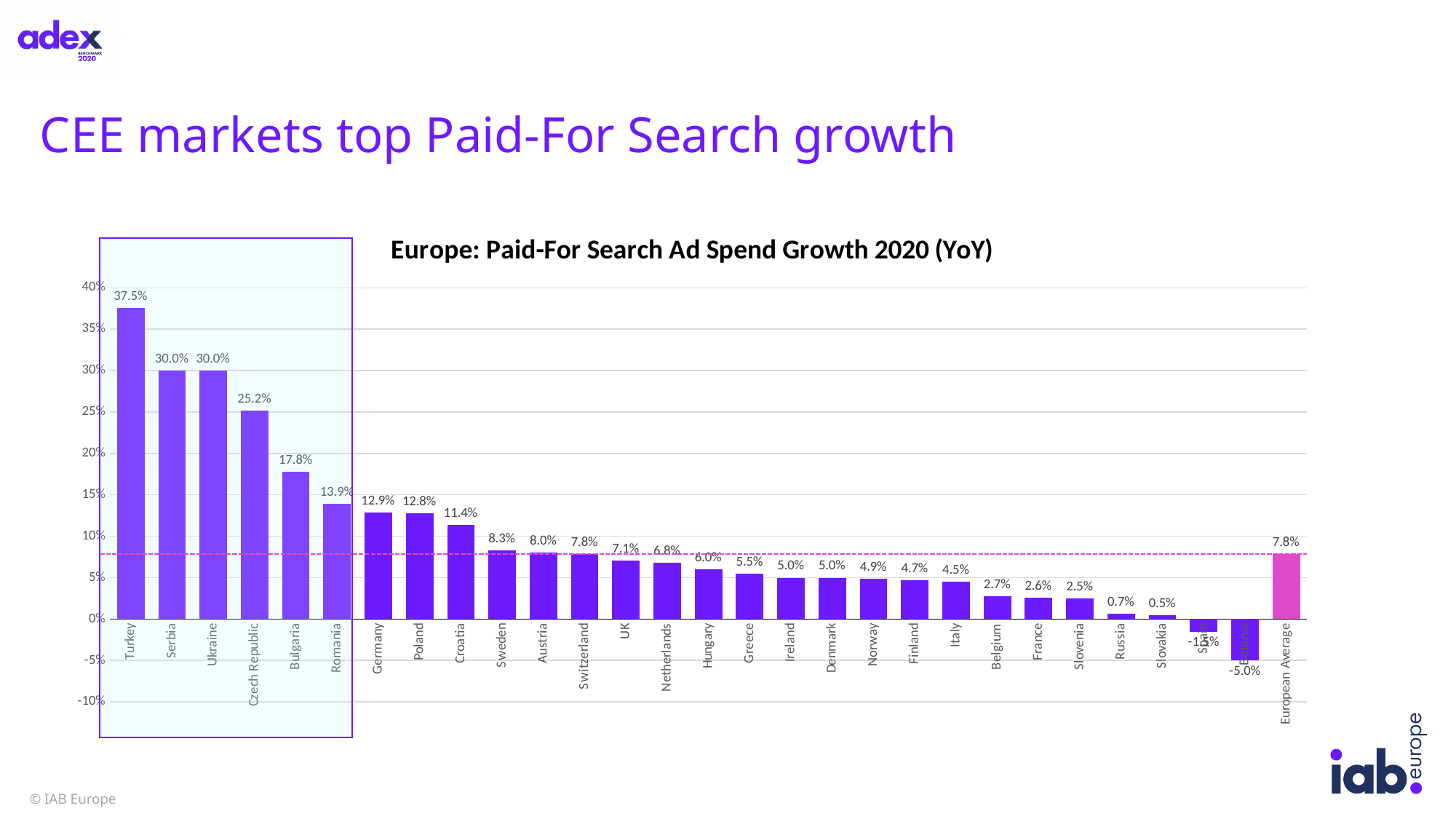
Which has the larger growth value, Germany or Poland? Germany What is the Paid-For Search ad spend growth for Turkey? 37.5% Which country has the highest Paid-For Search ad spend growth? Turkey Is the value for Romania greater or less than 10%? greater What is the European Average growth shown in the chart? 7.8% What is the title of the chart? Europe: Paid-For Search Ad Spend Growth 2020 (YoY) Do the values generally rise or fall moving from left to right across the country bars? Fall What kind of chart is shown on the slide? Bar chart What is the value shown for the Czech Republic? 25.2% What is the difference between Turkey's growth and Bulgaria's growth? 19.7% What is the difference between Sweden's growth and Austria's growth? 0.3% What is the value shown for Slovakia? 0.5%